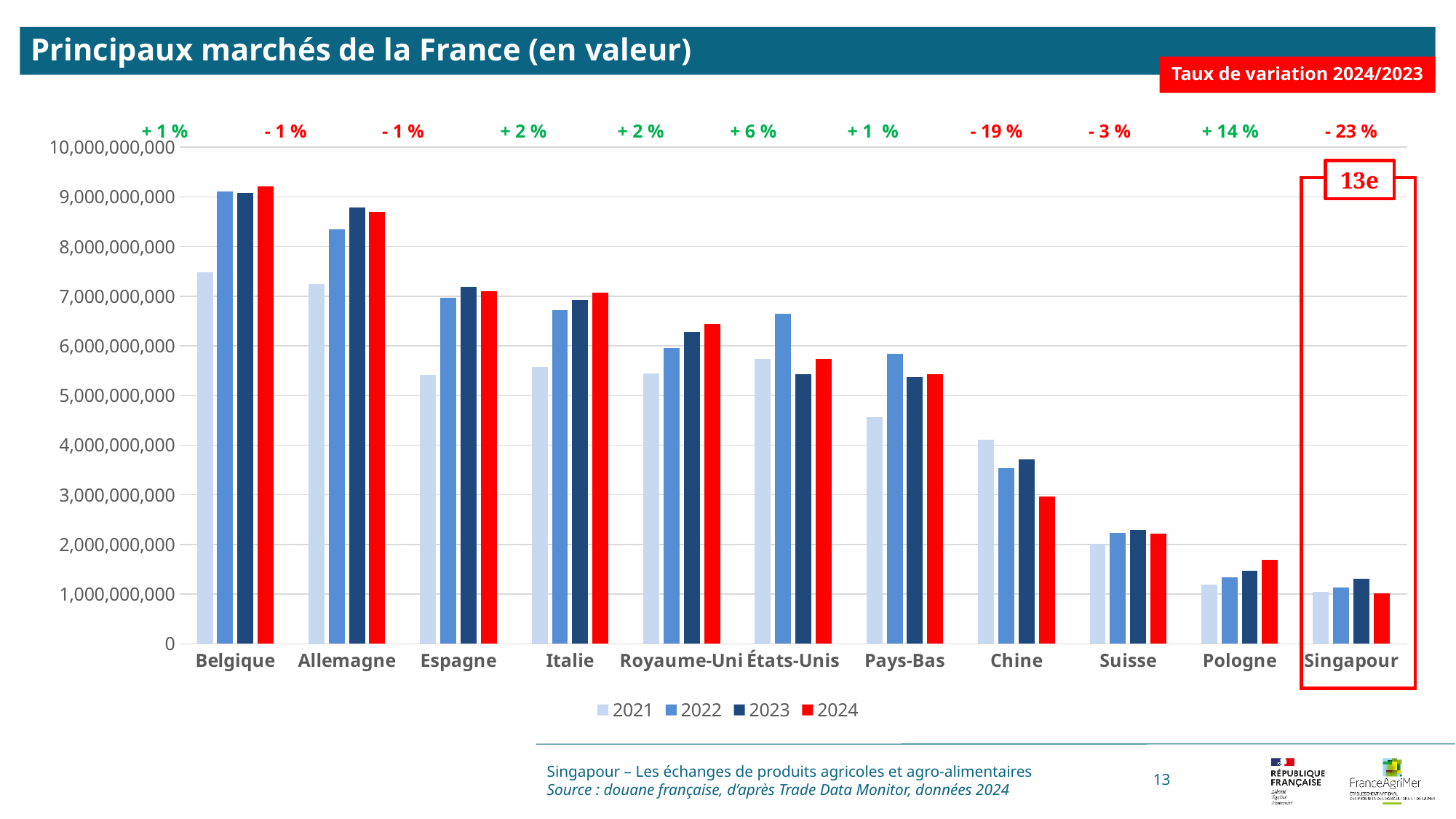
Which is larger, the 2024 value for Royaume-Uni or the 2024 value for États-Unis? Royaume-Uni Which country has the highest 2024/2023 variation rate printed above it? Pologne Is the 2024 value for Pologne greater or less than 2,000,000,000? less Do the values for Pologne rise or fall from 2021 to 2024? rise Is the 2024 value for Belgique greater or less than 9,000,000,000? greater What is the 2024/2023 variation rate printed above États-Unis? + 6 % How many countries are shown on the x axis of the chart? 11 What is the 2024/2023 variation rate printed above Singapour? - 23 % How many series does the legend list? 4 Which country has the highest value for 2024? Belgique What kind of chart is shown on the slide? bar chart Which country has the lowest value for 2024? Singapour